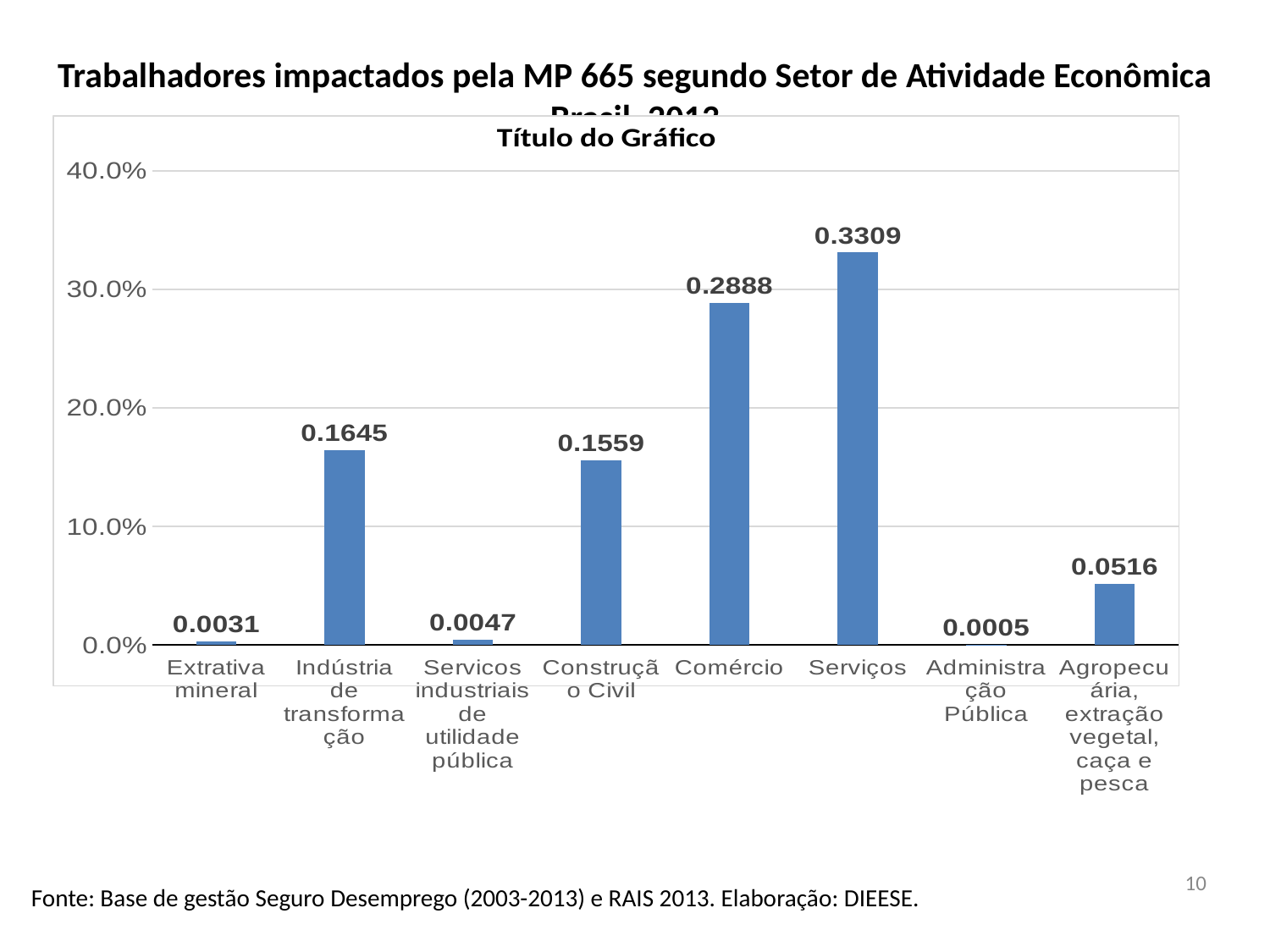
What kind of chart is shown on the slide? bar chart Which sector has the highest value? Serviços How many sectors are shown on the x axis? 8 What is the data label shown for Comércio? 0.2888 What is the data label shown for Extrativa mineral? 0.0031 What is the highest value shown on the y axis? 40.0% What is the difference between the data labels for Serviços and Comércio? 0.0421 What is the data label shown for Agropecuária, extração vegetal, caça e pesca? 0.0516 Which sector has the lowest value? Administração Pública Which is larger, the value for Indústria de transformação or the value for Construção Civil? Indústria de transformação Is the bar for Serviços greater or less than 30.0%? greater What is the data label shown for Construção Civil? 0.1559